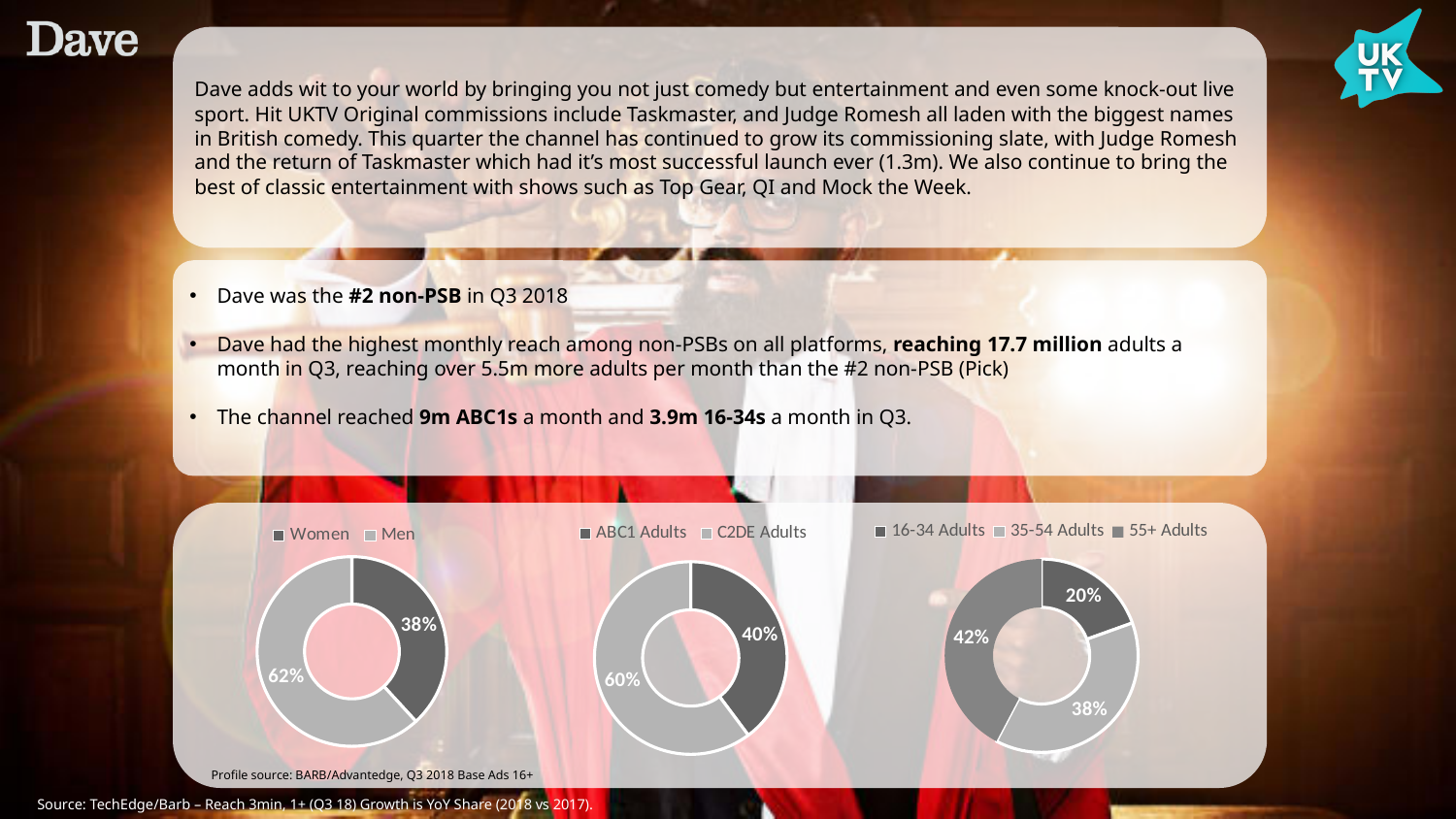
In the right doughnut chart, what percentage is shown for 16-34 Adults? 20% In the left doughnut chart, what percentage is shown for Women? 38% In the middle doughnut chart, which is larger, ABC1 Adults or C2DE Adults? C2DE Adults In the middle doughnut chart, what percentage is shown for C2DE Adults? 60% In the left doughnut chart, what percentage is shown for Men? 62% In the middle doughnut chart, what percentage is shown for ABC1 Adults? 40% In the left doughnut chart, what is the difference in percentage points between Men and Women? 24 What type of chart is used for the three charts at the bottom of the slide? Doughnut chart In the right doughnut chart, which age group has the largest share? 55+ Adults How many series does the legend of the right doughnut chart list? 3 In the right doughnut chart, which age group has the smallest share? 16-34 Adults In the right doughnut chart, what is the difference in percentage points between 55+ Adults and 35-54 Adults? 4